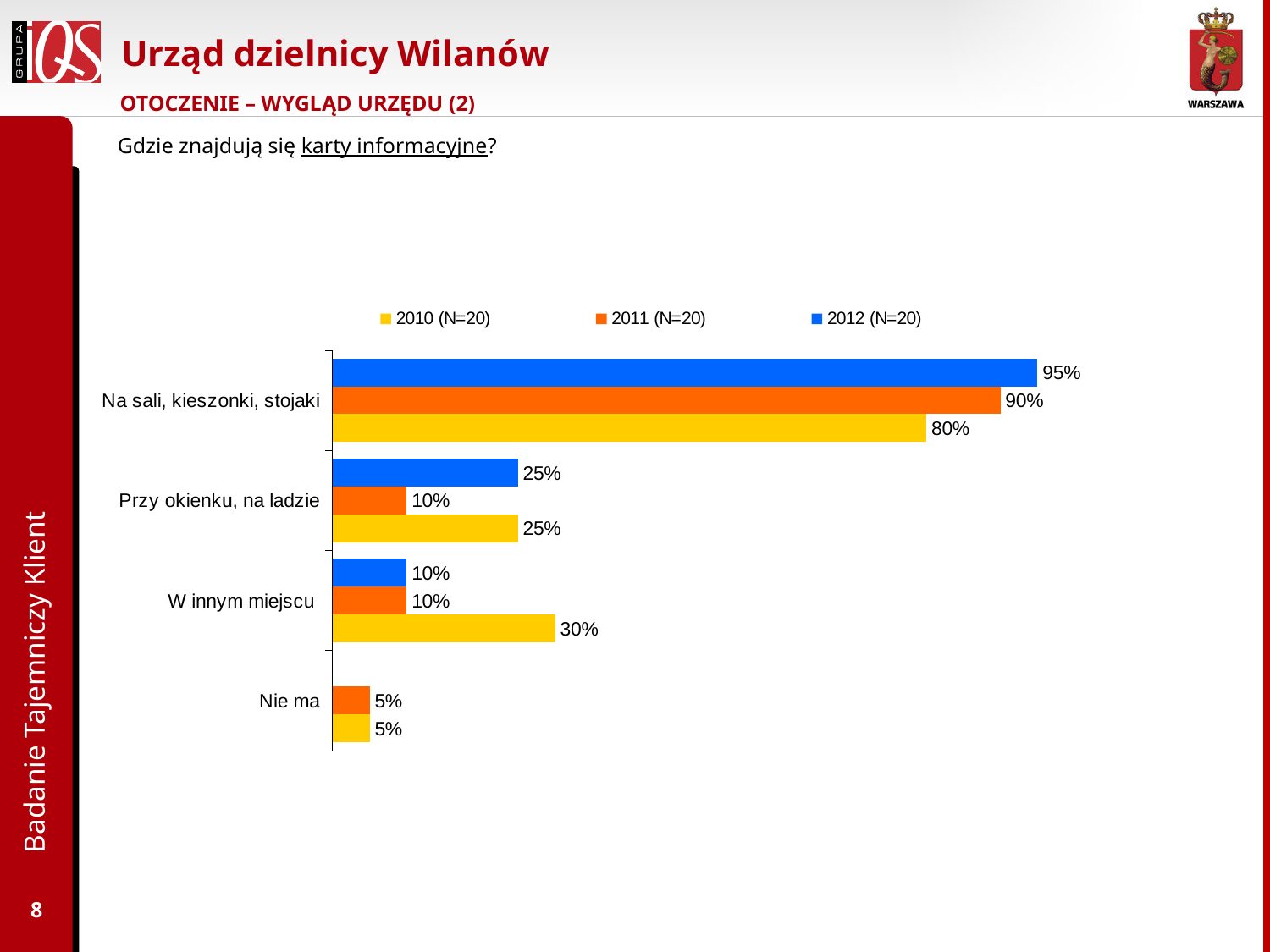
What is the value for 'Przy okienku, na ladzie' in the 2011 (N=20) series? 10% What is the value for 'Na sali, kieszonki, stojaki' in the 2012 (N=20) series? 95% Which category has the highest value in the 2012 (N=20) series? Na sali, kieszonki, stojaki What kind of chart is shown on the slide? bar chart What is the value for 'Na sali, kieszonki, stojaki' in the 2010 (N=20) series? 80% How many series does the legend list? 3 Which category has the lowest value in the 2010 (N=20) series? Nie ma For 'W innym miejscu', which is larger: the 2010 (N=20) value or the 2012 (N=20) value? 2010 (N=20) How many categories are shown on the chart? 4 What is the difference between the 2012 (N=20) and 2010 (N=20) values for 'Na sali, kieszonki, stojaki'? 15% What is the value for 'W innym miejscu' in the 2010 (N=20) series? 30% Which colour represents the 2011 (N=20) series in the chart? orange